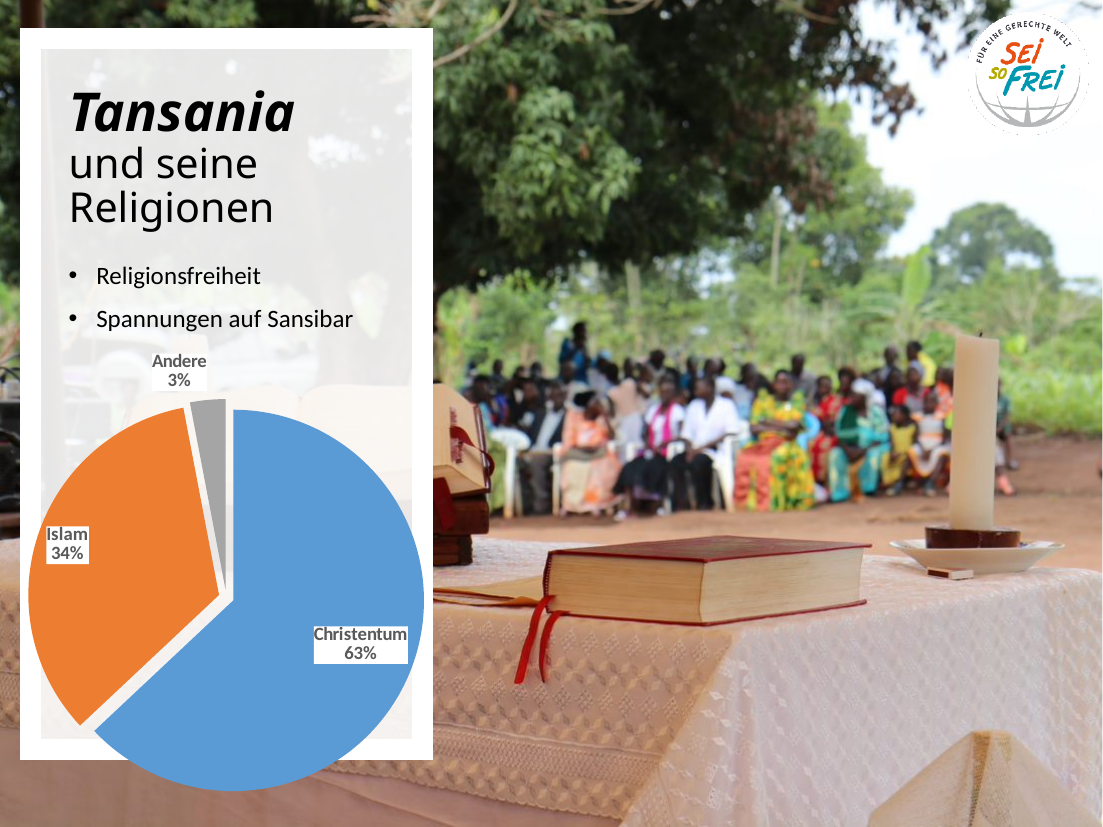
Which slice of the pie is the smallest? Andere What colour is the Islam slice of the pie? orange What share of the pie does Andere have? 3% How many slices does the pie chart have? 3 What share of the pie does Islam have? 34% What kind of chart is shown on the slide? pie chart What colour is the Christentum slice of the pie? blue What is the difference in percentage points between Christentum and Islam? 29 Which slice of the pie is the largest? Christentum What is the difference in percentage points between Islam and Andere? 31 What share of the pie does Christentum have? 63% Which is larger, the share for Islam or the share for Andere? Islam